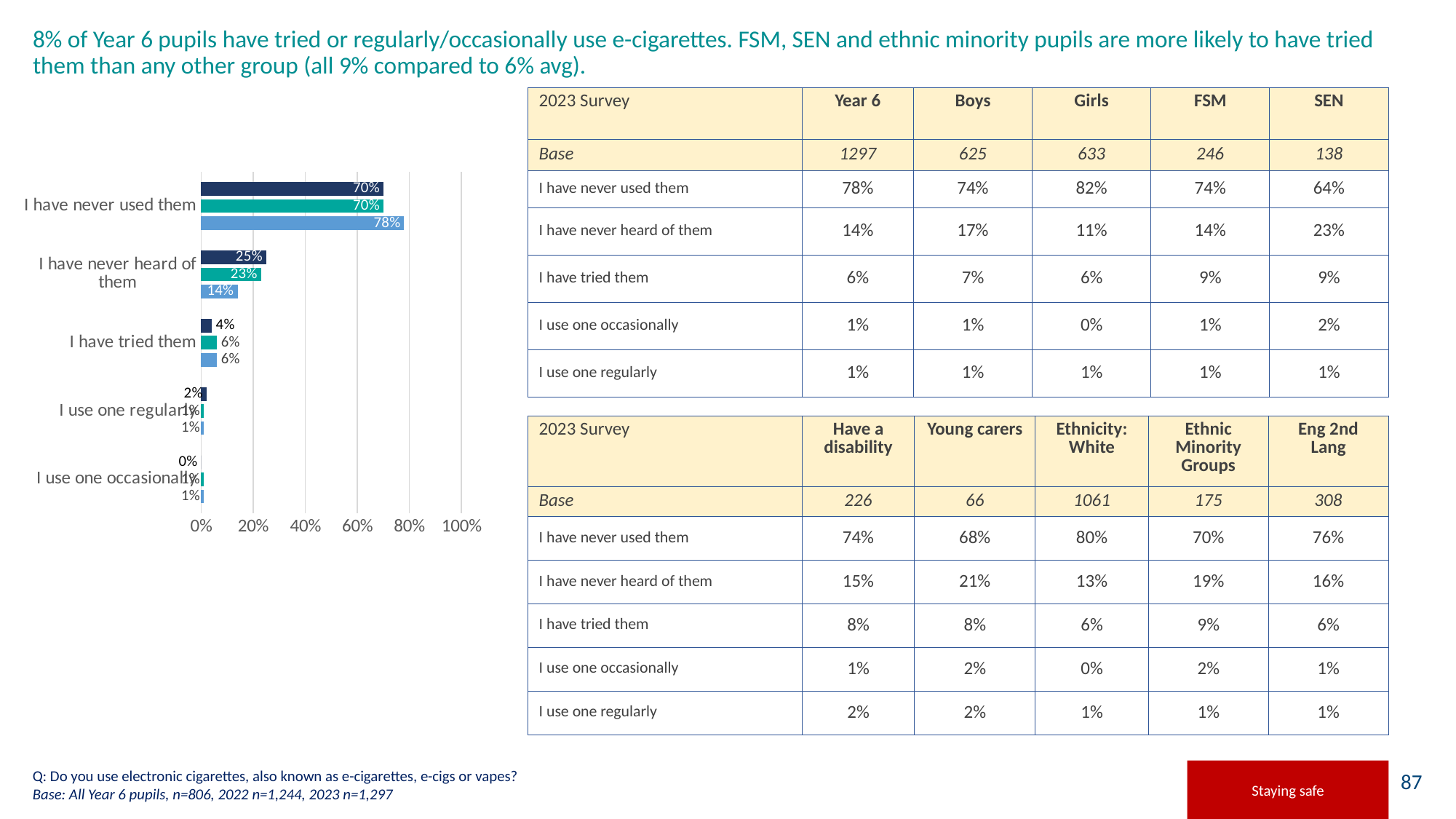
In the bar chart, what is the difference between the light blue bars for 'I have never used them' and 'I have never heard of them'? 64 percentage points In the bar chart, what is the value of the dark navy bar for 'I have tried them'? 4% In the bar chart, what is the value of the dark navy bar for 'I use one occasionally'? 0% How many bars are plotted for each category in the bar chart? 3 In the bar chart, for 'I have never heard of them', which is larger: the dark navy bar or the teal bar? dark navy bar In the bar chart, which category has the highest light blue bar? I have never used them In the bar chart, what is the value of the dark navy bar for 'I have never heard of them'? 25% What type of chart is shown on the left of the slide? bar chart How many response categories are shown on the bar chart? 5 In the bar chart, which category has the lowest dark navy bar? I use one occasionally In the bar chart, is the light blue bar for 'I have never used them' greater or less than 60%? greater In the bar chart, what is the value of the light blue bar for 'I have never used them'? 78%